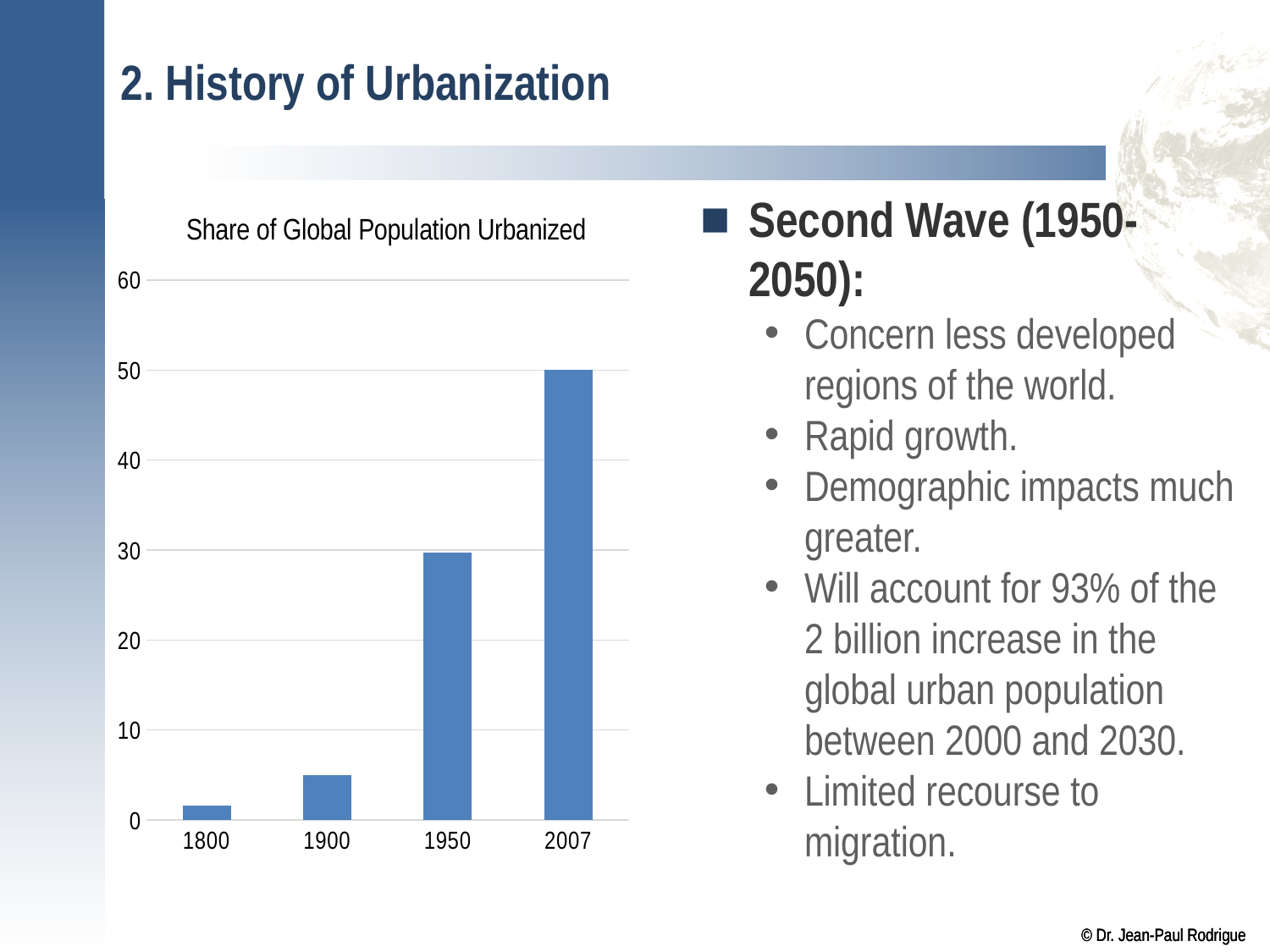
What is the highest value shown on the y axis of the chart? 60 What kind of chart is shown on the slide? bar chart Is the value for 1900 greater or less than 10? less How many years are shown on the x axis of the chart? 4 What is the title of the chart? Share of Global Population Urbanized Which year has the highest share of global population urbanized? 2007 Which is larger, the value for 1950 or the value for 1900? 1950 Which year has the lowest share of global population urbanized? 1800 Do the values rise or fall from 1800 to 2007? rise Is the value for 2007 greater or less than 40? greater Is the value for 1800 greater or less than 10? less